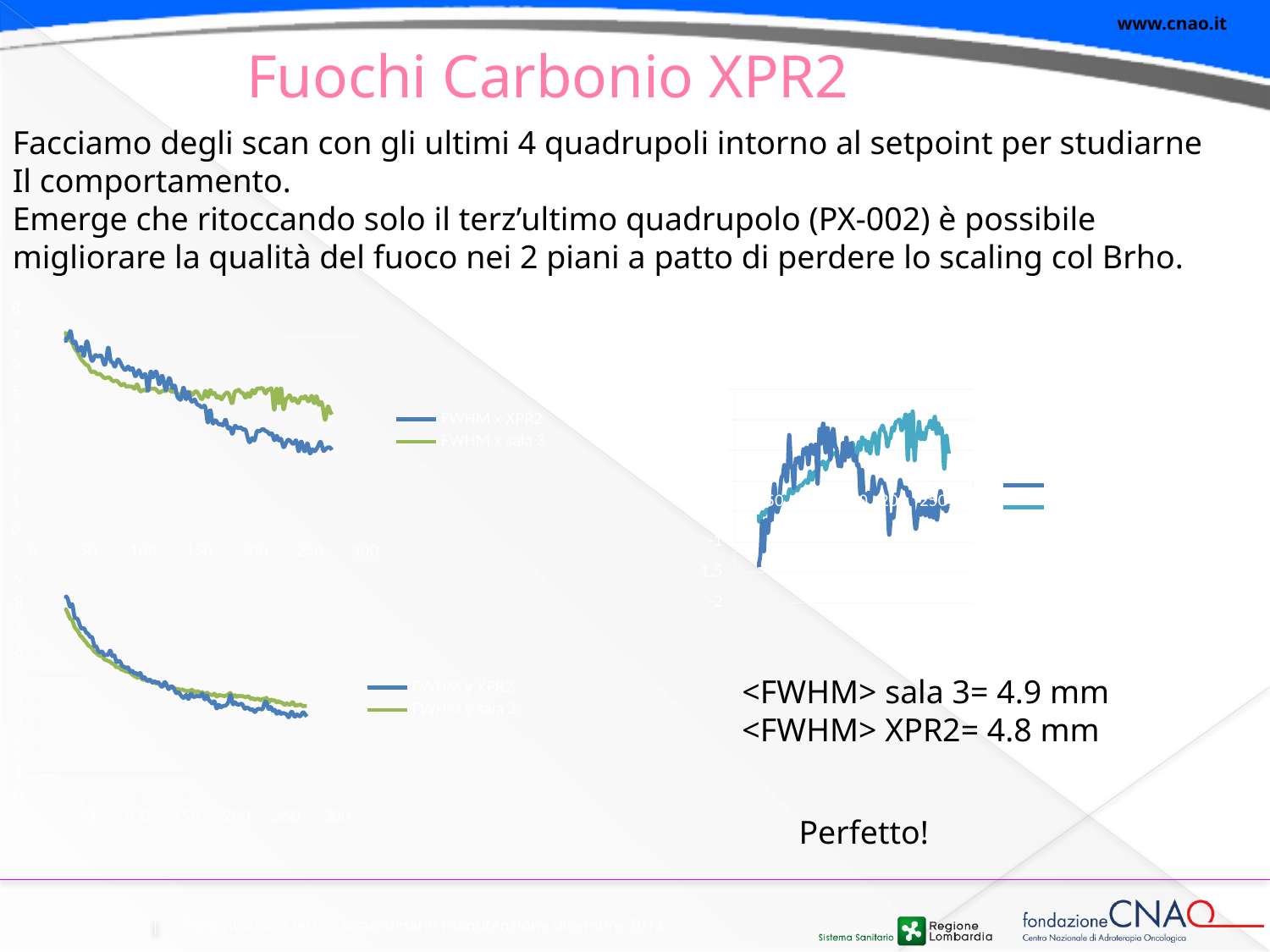
In the top-left chart, is the starting value of FWHM x XPR2 (near x = 0) greater or less than 6? greater In the bottom-left chart, is the starting value of FWHM y XPR2 (near x = 0) greater or less than 7? greater What are the two legend entries of the top-left chart? FWHM x XPR2 and FWHM x sala 3 How many charts are shown on the slide? 3 In the bottom-left chart, do the values of FWHM y sala 3 rise or fall along the x axis? fall In the top-left chart, at the right end of the lines (around x = 250), which series is higher, FWHM x XPR2 or FWHM x sala 3? FWHM x sala 3 What kind of chart is the top-left chart on the slide? line chart What are the two legend entries of the bottom-left chart? FWHM y XPR2 and FWHM y sala 3 How many series does the legend of the top-left chart list? 2 How many series does the legend of the bottom-left chart list? 2 In the top-left chart, is the value of FWHM x XPR2 near x = 250 greater or less than 4? less In the top-left chart, do the values of FWHM x XPR2 rise or fall along the x axis? fall